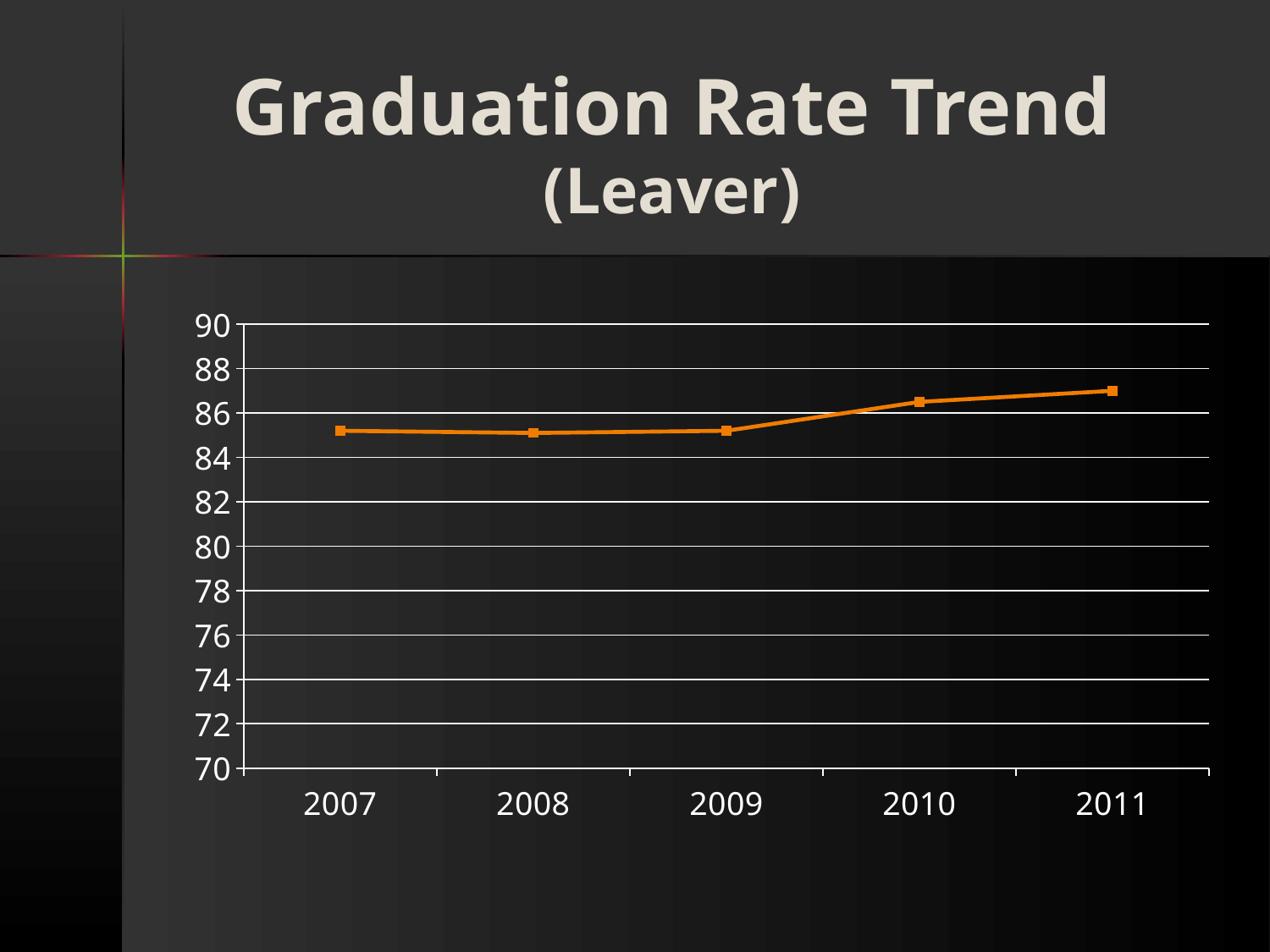
Is the value for 2007 greater or less than 86? less What kind of chart is shown on the slide? line chart Is the value for 2009 greater or less than 86? less Which is larger, the value for 2011 or the value for 2007? 2011 Is the value for 2011 greater or less than 86? greater Do the values rise or fall from 2009 to 2011? rise How many years are plotted on the x axis? 5 Which year has the highest graduation rate? 2011 What is the title of the slide containing the chart? Graduation Rate Trend (Leaver) Which is larger, the value for 2010 or the value for 2008? 2010